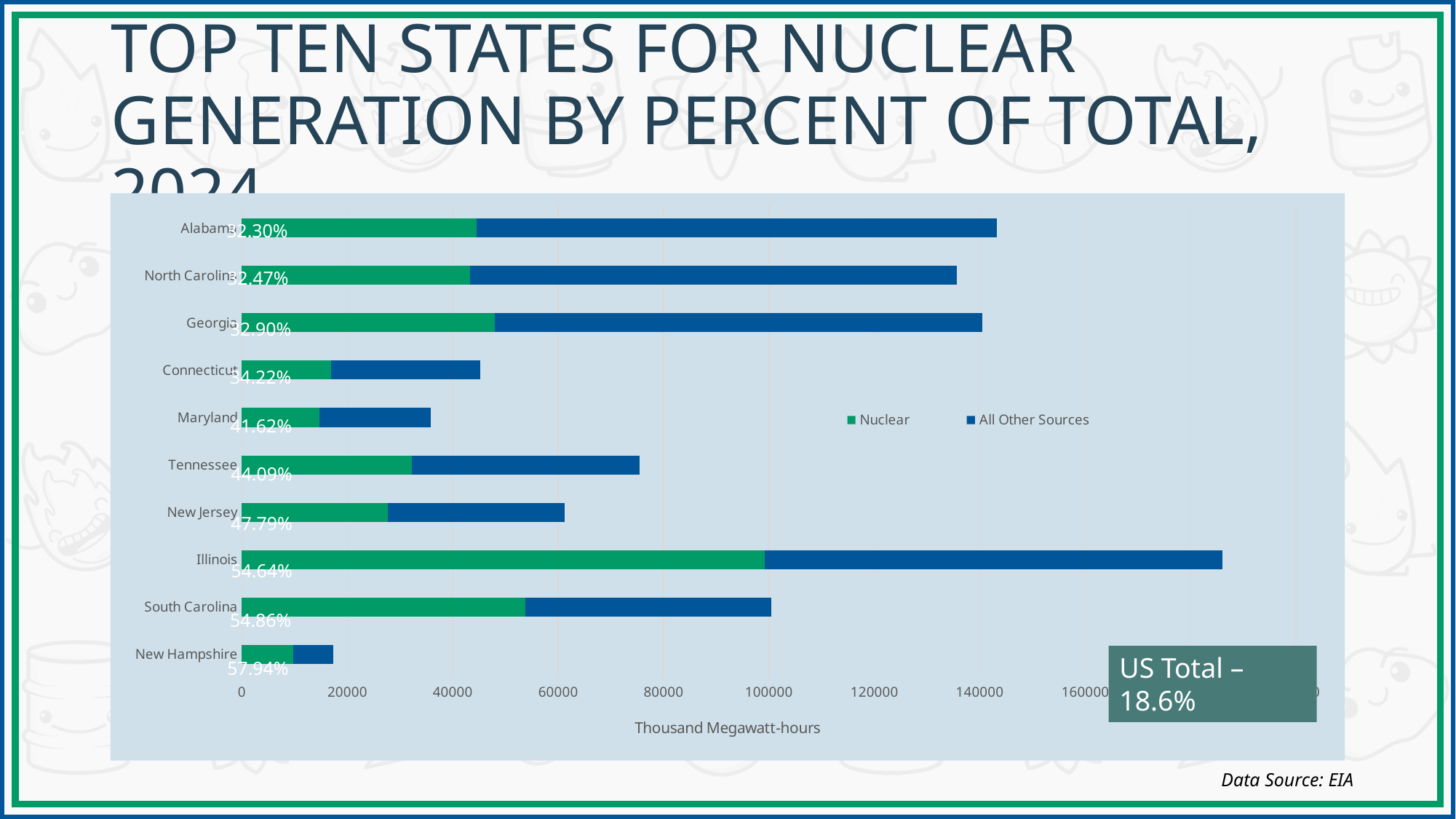
How many series does the legend list? 2 What percentage label is shown for New Hampshire? 57.94% Is the total bar length for Illinois greater or less than 160000? greater What percentage label is shown for Maryland? 41.62% What kind of chart is shown on the slide? Stacked bar chart Is the total bar length for Maryland greater or less than 40000? less Which state has the longest total bar in the chart? Illinois How many states are shown in the chart? 10 What percentage label is shown for New Jersey? 47.79% What is the title of the x axis? Thousand Megawatt-hours What percentage label is shown for Illinois? 54.64% Which state has the shortest total bar in the chart? New Hampshire